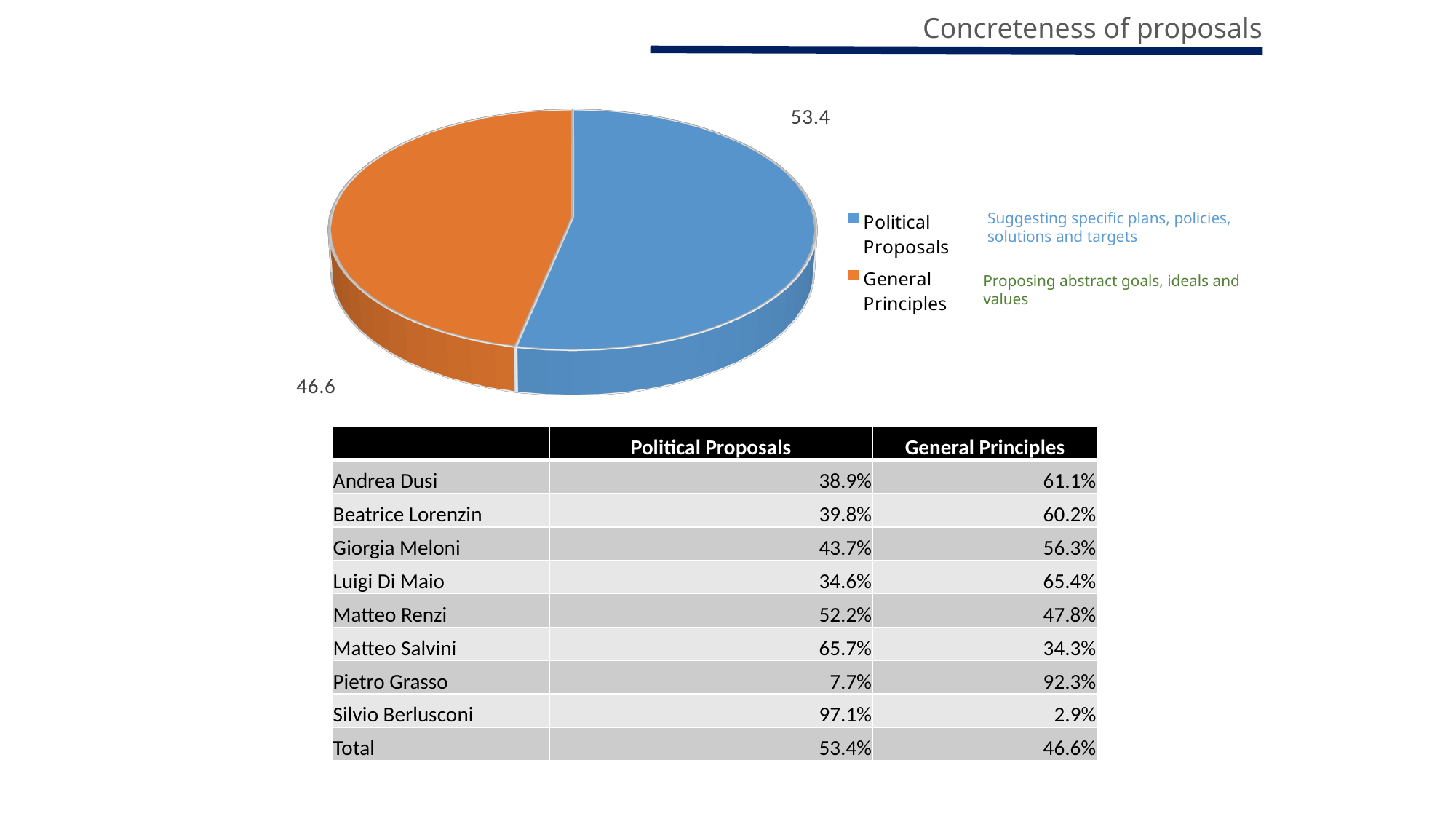
How many slices does the pie chart have? 2 What share of the pie does the General Principles slice represent? 46.6 What type of chart is shown on the slide? pie chart What is the value shown for the Political Proposals slice of the pie chart? 53.4 Which slice of the pie chart is the largest? Political Proposals What is the value shown for the General Principles slice of the pie chart? 46.6 What colour is the Political Proposals slice in the pie chart? blue What is the difference between the Political Proposals value and the General Principles value in the pie chart? 6.8 How many entries does the pie chart's legend list? 2 Which slice of the pie chart is the smallest? General Principles In the pie chart, which is larger: Political Proposals or General Principles? Political Proposals What is the title shown at the top of the slide above the pie chart? Concreteness of proposals